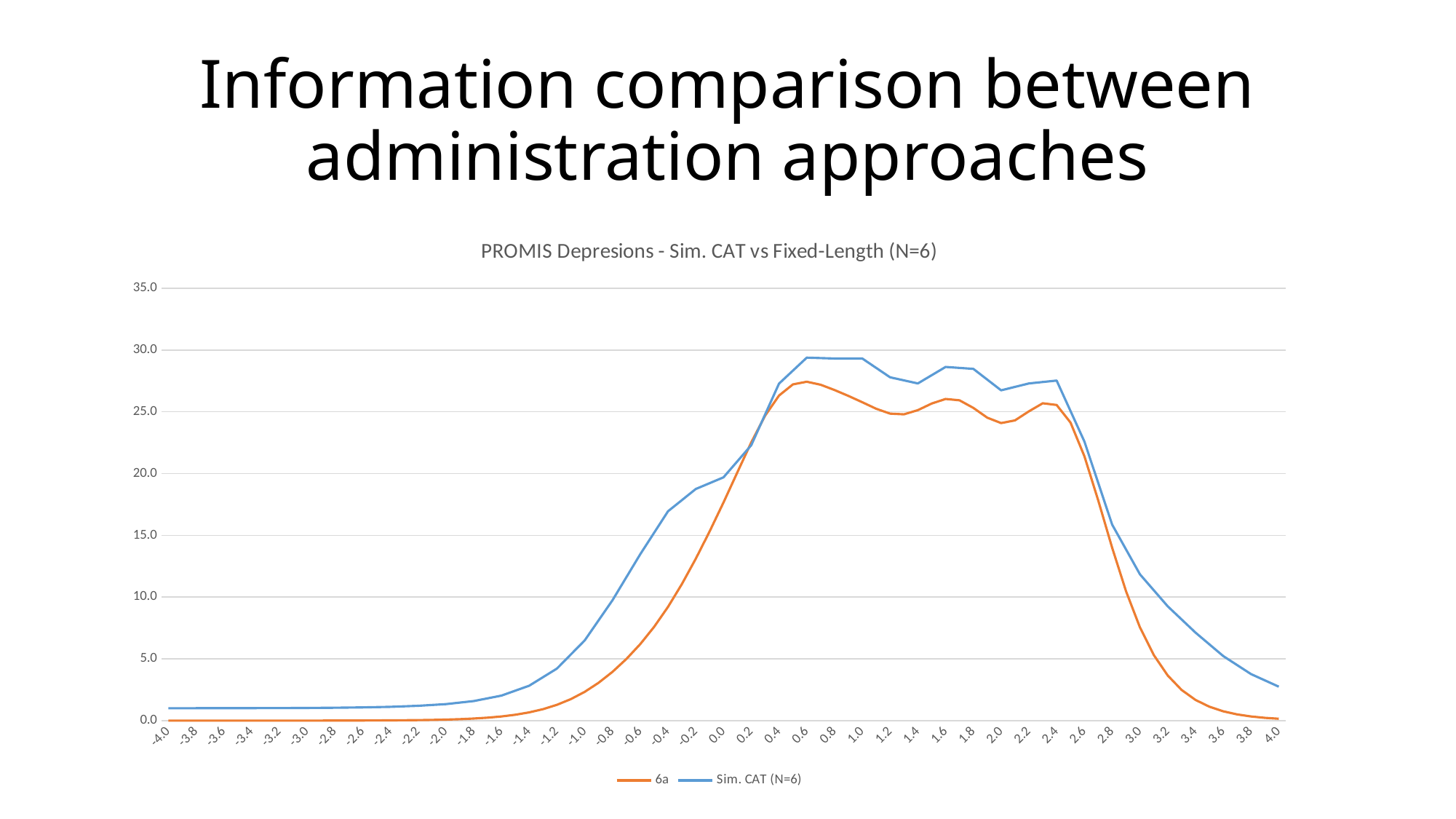
At -0.6, which series has the larger value, 6a or Sim. CAT (N=6)? Sim. CAT (N=6) Which series is drawn in blue? Sim. CAT (N=6) Is the value of 6a at -1.0 greater or less than 5? less What kind of chart is shown on the slide? line chart Do the values of both series rise or fall between 2.4 and 4.0 on the x axis? fall How many series does the legend list? 2 Is the value of Sim. CAT (N=6) at 0.6 greater or less than 25? greater Is the value of Sim. CAT (N=6) at 3.0 greater or less than 10? greater Which series reaches the higher peak value? Sim. CAT (N=6) What is the title of the chart? PROMIS Depresions - Sim. CAT vs Fixed-Length (N=6)